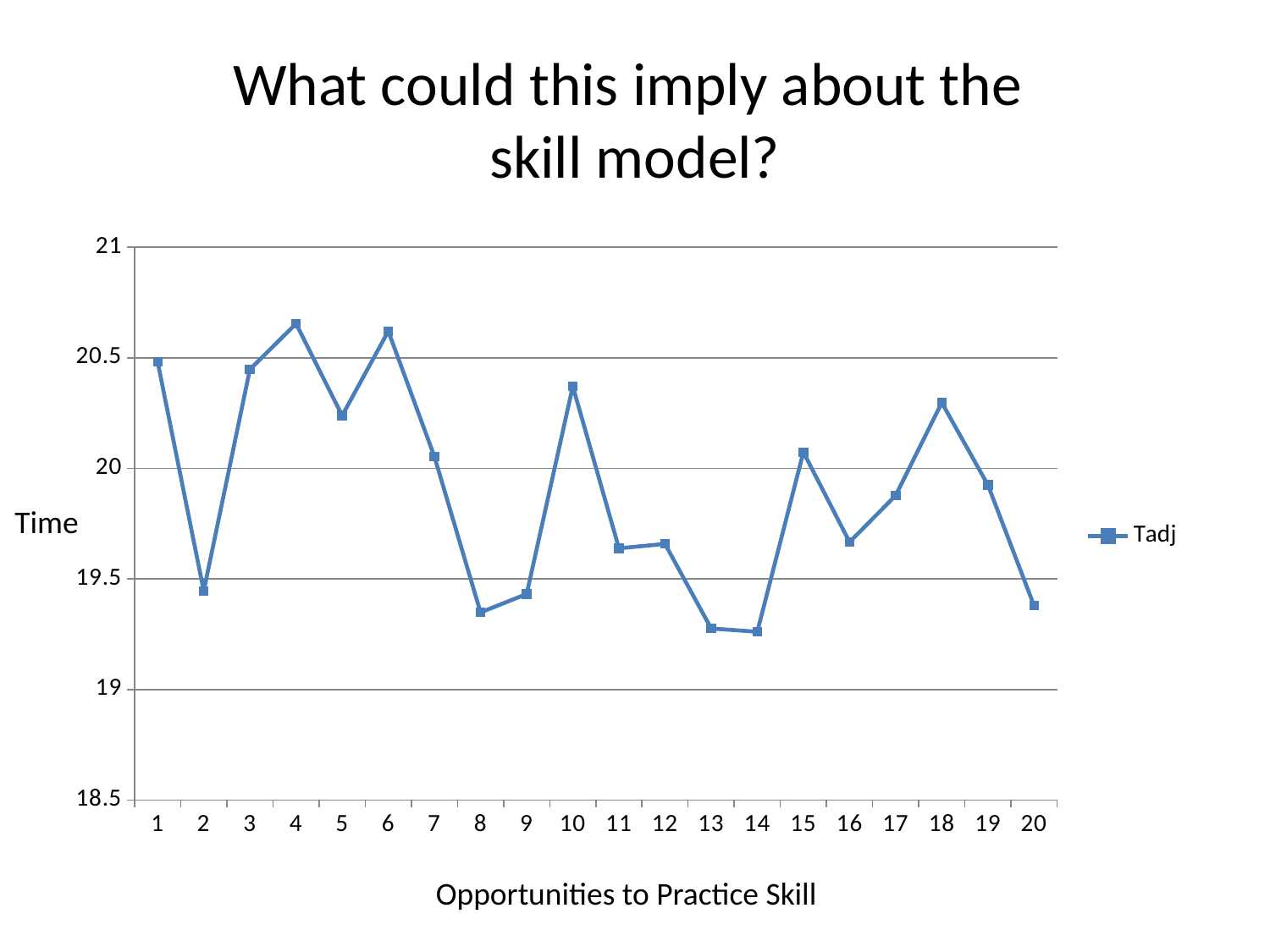
Which has the larger Tadj value, opportunity 18 or opportunity 20? opportunity 18 How many data points are plotted along the x axis? 20 How many series does the legend list? 1 Is the Tadj value at opportunity 13 greater or less than 19.5? less Is the Tadj value at opportunity 2 greater or less than 20? less Is the Tadj value at opportunity 4 greater or less than 20.5? greater What is the label of the x axis? Opportunities to Practice Skill What is the name of the series shown in the legend? Tadj Which has the larger Tadj value, opportunity 10 or opportunity 11? opportunity 10 Overall, do the Tadj values rise or fall from opportunity 1 to opportunity 20? fall What kind of chart is shown on the slide? line chart